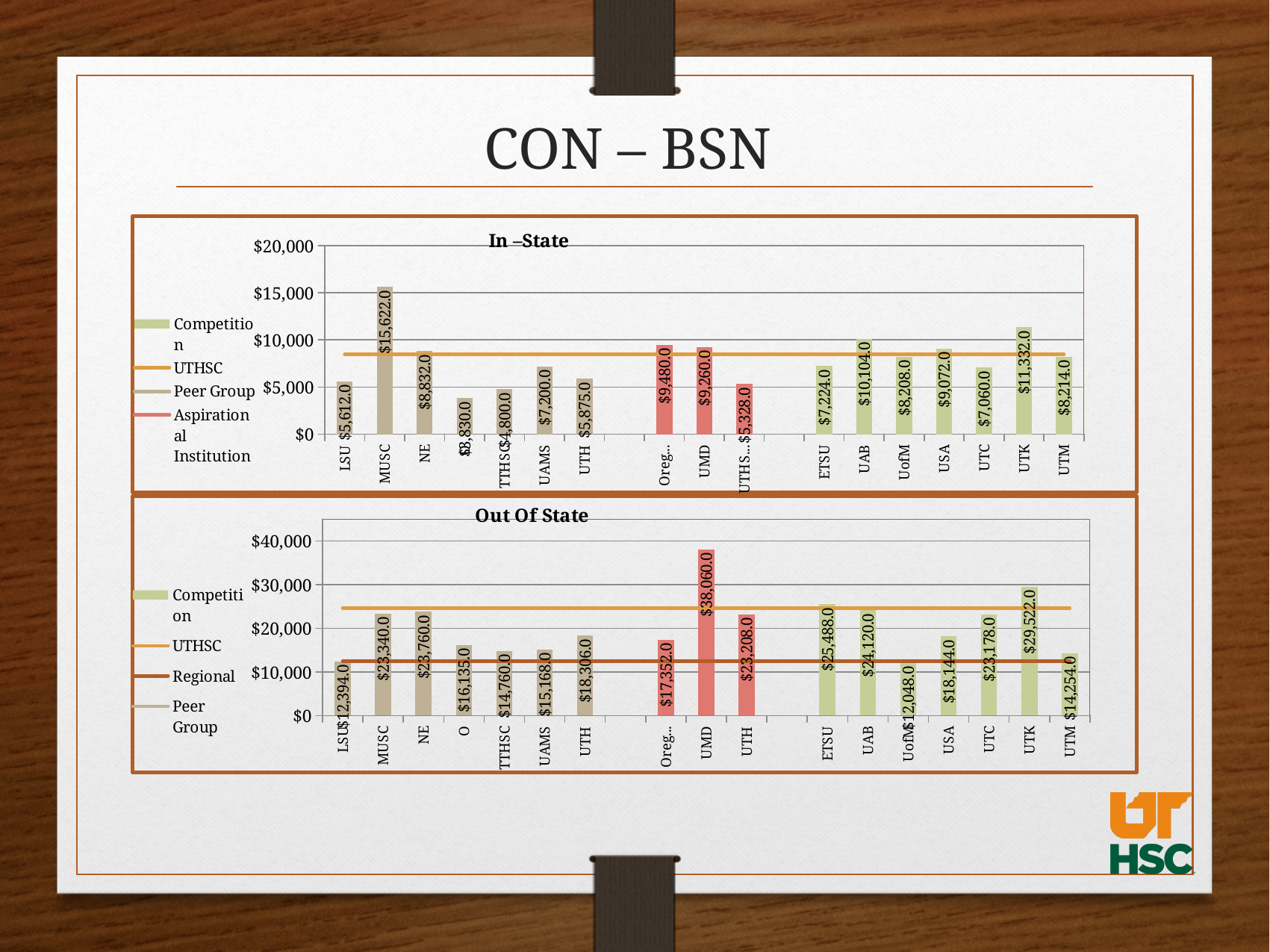
In the In-State chart, which institution has the highest value? MUSC In the In-State chart, which is larger, the value for UAMS or the value for UTC? UAMS In the In-State chart, which institution has the lowest value? O In the In-State chart, what is the difference between the values for UTK and UAB? $1,228.0 In the In-State chart, what is the value for MUSC? $15,622.0 In the Out Of State chart, what is the difference between the values for UTK and ETSU? $4,034.0 How many entries does the legend of the In-State chart list? 4 In the Out Of State chart, what is the value for UMD? $38,060.0 In the Out Of State chart, which institution has the highest value? UMD In the Out Of State chart, is the value for MUSC greater or less than $20,000? greater In the Out Of State chart, what is the value for UTK? $29,522.0 What kind of chart is the Out Of State chart? Bar chart